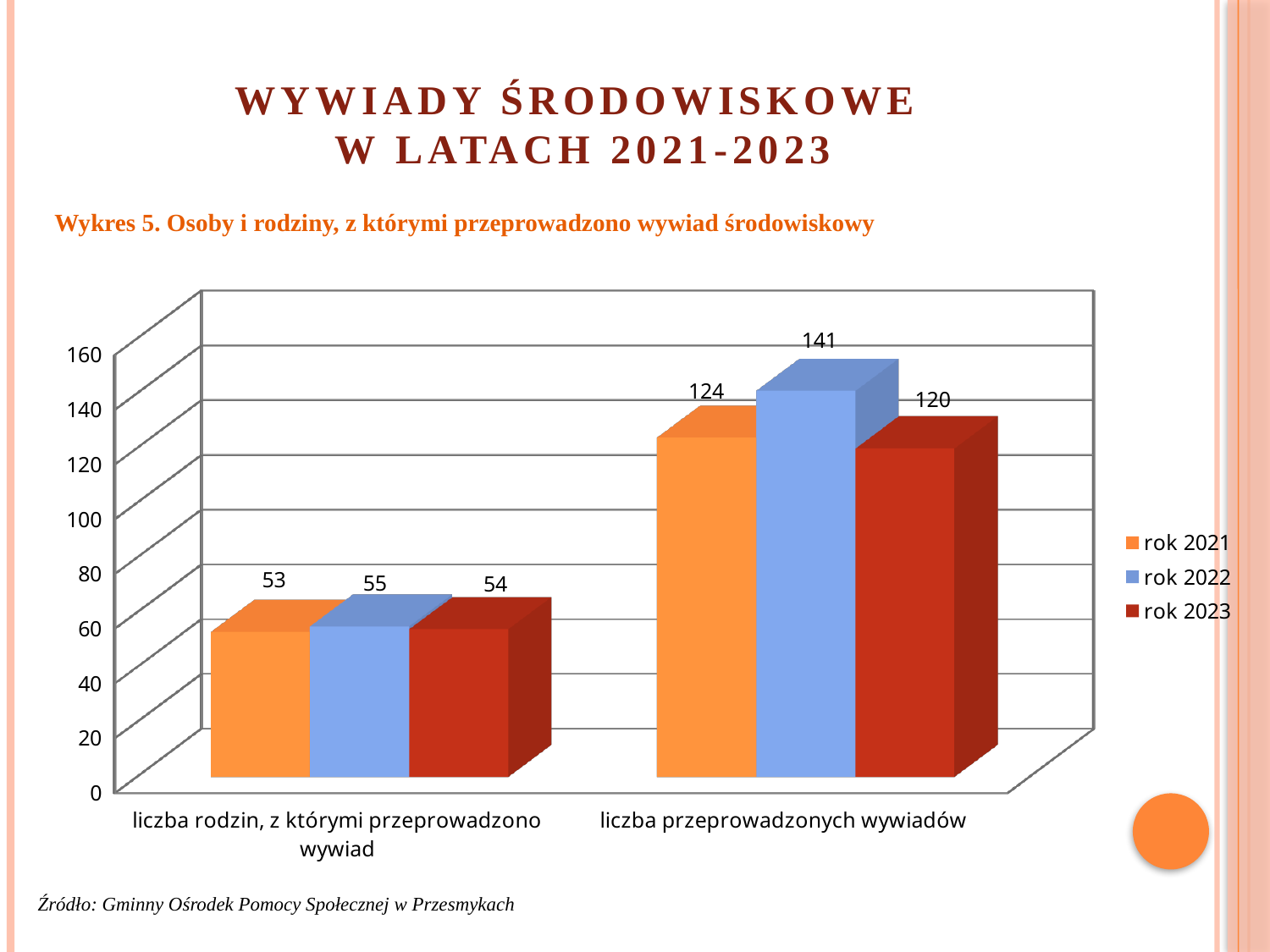
What is the value for rok 2023 in the category 'liczba przeprowadzonych wywiadów'? 120 How many series does the legend list? 3 How many categories are shown on the x axis? 2 What is the value for rok 2021 in the category 'liczba rodzin, z którymi przeprowadzono wywiad'? 53 Which year has the highest value for 'liczba przeprowadzonych wywiadów'? rok 2022 What is the difference between the rok 2022 and rok 2021 values for 'liczba przeprowadzonych wywiadów'? 17 What is the title of the chart (Wykres 5)? Osoby i rodziny, z którymi przeprowadzono wywiad środowiskowy Which is larger: the rok 2021 value for 'liczba przeprowadzonych wywiadów' or the rok 2023 value for the same category? rok 2021 Which year has the lowest value for 'liczba przeprowadzonych wywiadów'? rok 2023 What is the value for rok 2022 in the category 'liczba przeprowadzonych wywiadów'? 141 What is the difference between the rok 2022 and rok 2023 values for 'liczba rodzin, z którymi przeprowadzono wywiad'? 1 What kind of chart is shown on the slide? bar chart